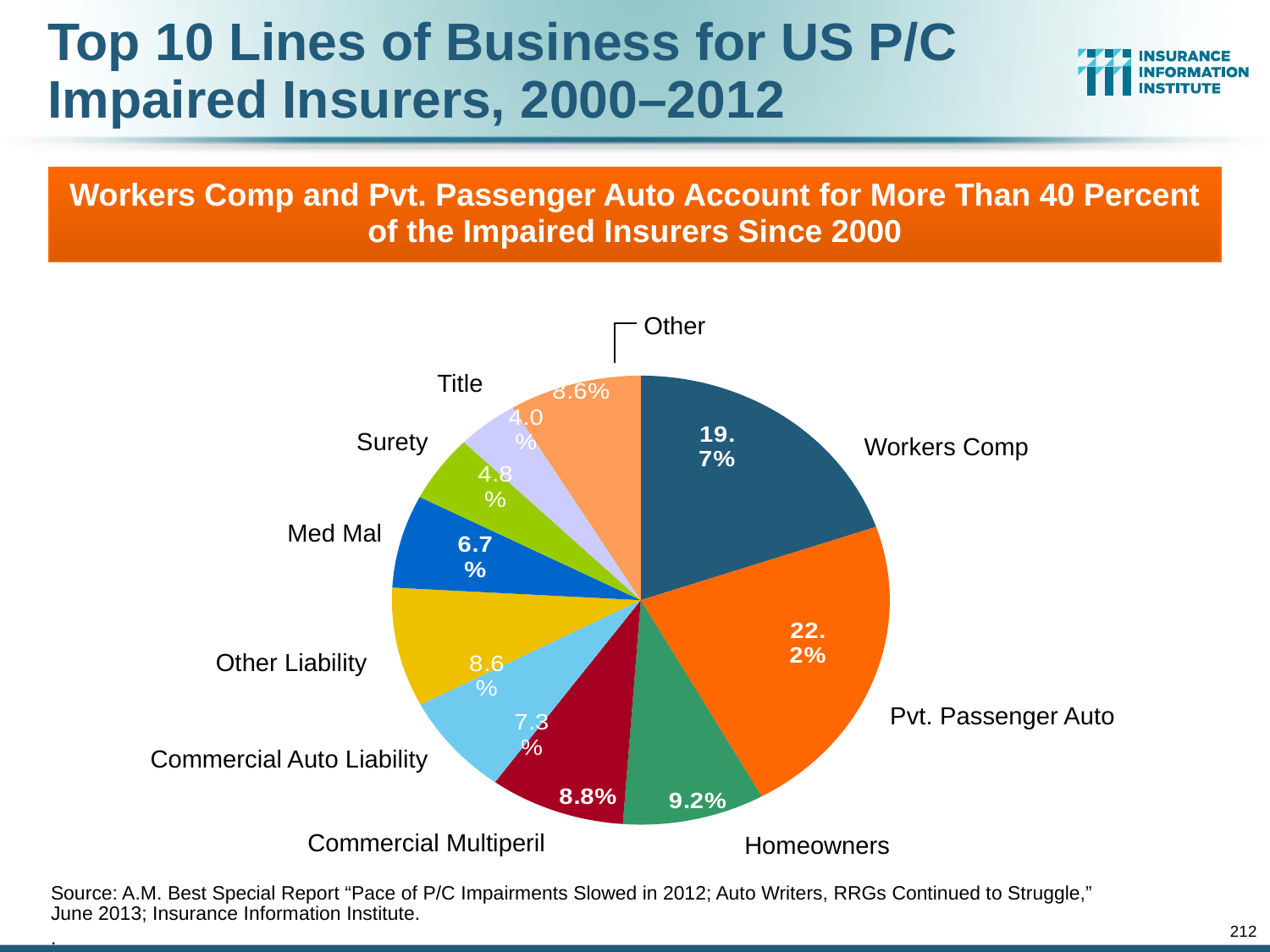
What is the value shown for Commercial Auto Liability? 7.3% Which is larger, the share for Homeowners or the share for Commercial Multiperil? Homeowners How many slices does the pie chart have? 10 What is the value shown for Homeowners? 9.2% What is the combined share of Workers Comp and Pvt. Passenger Auto? 41.9% Which line of business has the largest slice of the pie? Pvt. Passenger Auto Which line of business has the smallest slice of the pie? Title What share of impaired insurers does Workers Comp account for? 19.7% What is the value shown for Med Mal? 6.7% What is the difference between the Pvt. Passenger Auto share and the Workers Comp share? 2.5% What kind of chart is shown on the slide? pie chart What share of impaired insurers does Pvt. Passenger Auto account for? 22.2%